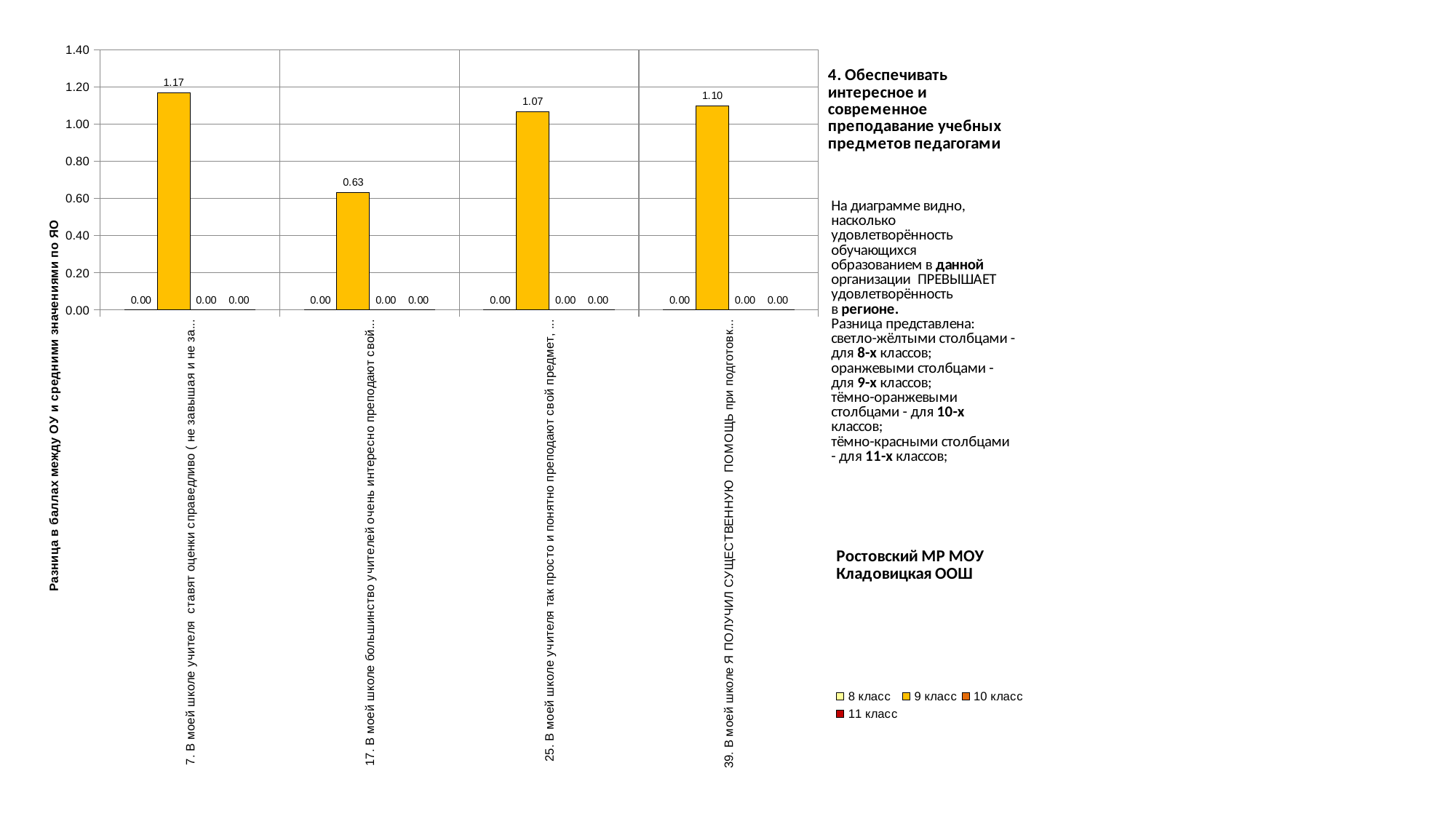
In which category is the 9 класс value highest? 7. В моей школе учителя ставят оценки справедливо... What is the difference between the 9 класс values in category 7 and category 17? 0.54 What is the value for 9 класс in category 17 ("В моей школе большинство учителей очень интересно преподают...")? 0.63 How many categories are shown on the x axis? 4 What is the value for 9 класс in category 25 ("В моей школе учителя так просто и понятно преподают свой предмет...")? 1.07 How many series does the legend list? 4 In which category is the 9 класс value lowest? 17. В моей школе большинство учителей очень интересно преподают... What is the value for 8 класс in category 7? 0.00 Which is larger for 9 класс: the value in category 25 or the value in category 39? Category 39 (1.10) What is the value for 9 класс in category 7 ("В моей школе учителя ставят оценки справедливо...")? 1.17 What is the value for 9 класс in category 39 ("В моей школе Я ПОЛУЧИЛ СУЩЕСТВЕННУЮ ПОМОЩЬ...")? 1.10 What kind of chart is shown on the slide? Bar chart